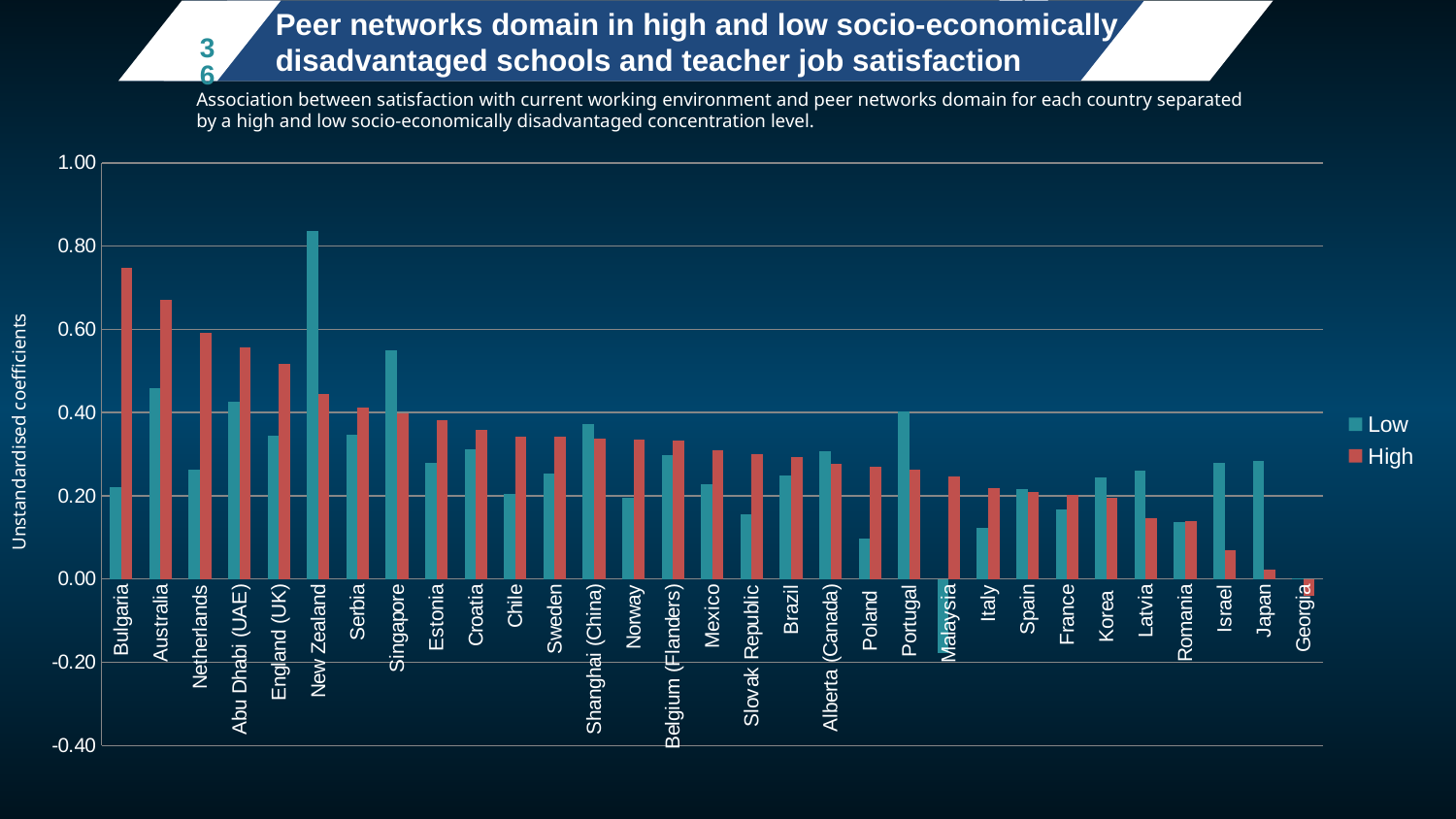
Which country has the highest value for the High series? Bulgaria What kind of chart is shown on the slide? bar chart Is the Low value for Singapore greater or less than 0.40? greater Which country has the lowest value for the High series? Georgia Is the Low value for Poland greater or less than 0.20? less How many countries or regions are shown on the x axis? 31 For Bulgaria, which is larger, the Low value or the High value? High Do the High series values generally rise or fall from left to right across the x axis? fall Which country has the highest value for the Low series? New Zealand How many series does the legend list? 2 Is the High value for Bulgaria greater or less than 0.60? greater For New Zealand, which is larger, the Low value or the High value? Low